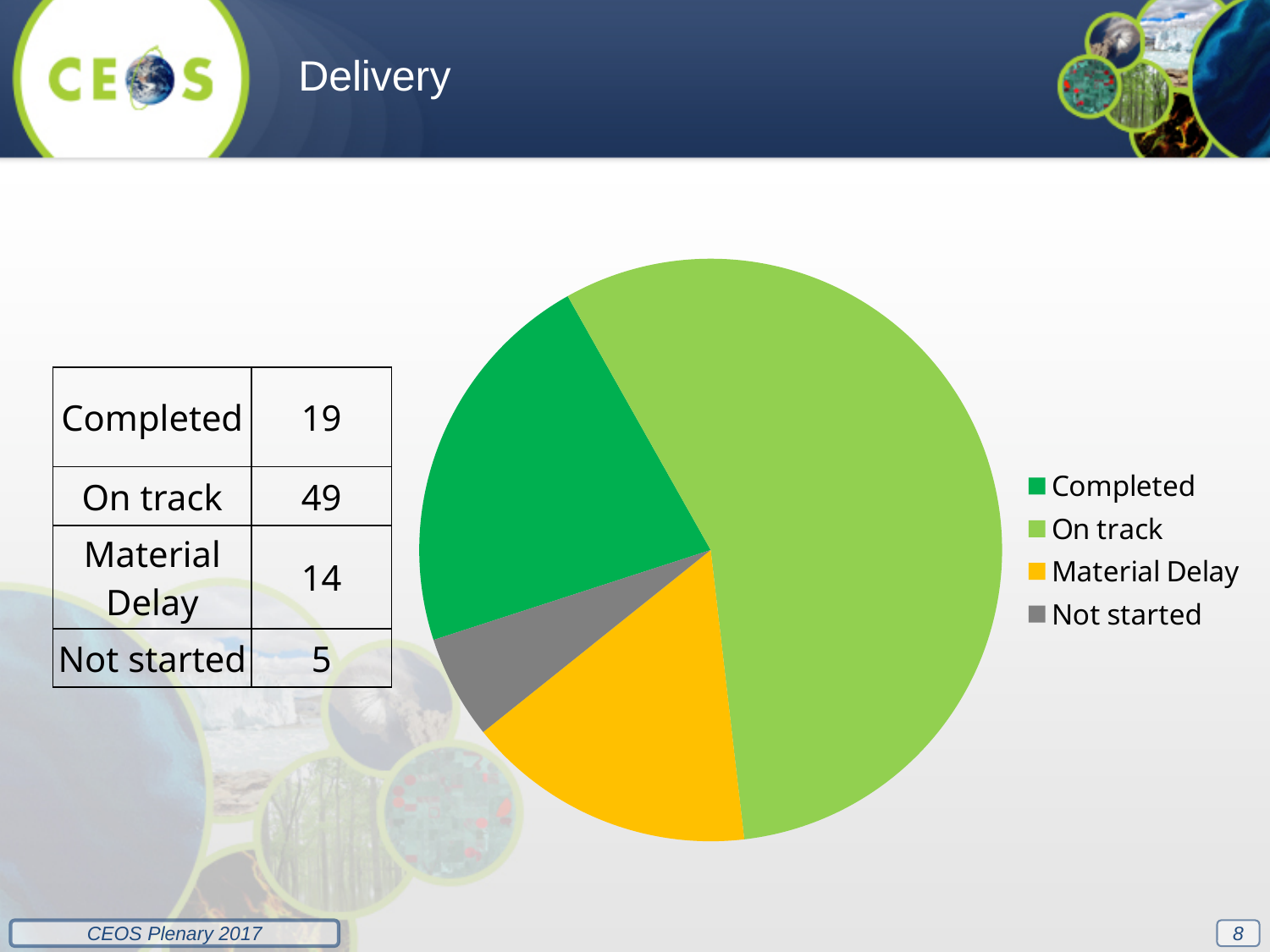
Which is larger, the value for Completed or the value for Material Delay? Completed What is the value for On track? 49 What colour is the Material Delay slice in the pie chart? yellow Which category has the smallest slice of the pie? Not started What is the value for Material Delay? 14 Which category has the largest slice of the pie? On track What is the difference between the On track value and the Completed value? 30 How many categories does the pie chart have? 4 What is the value for Completed? 19 What kind of chart is shown on the slide? pie chart What is the value for Not started? 5 What is the total of all four categories in the pie chart? 87